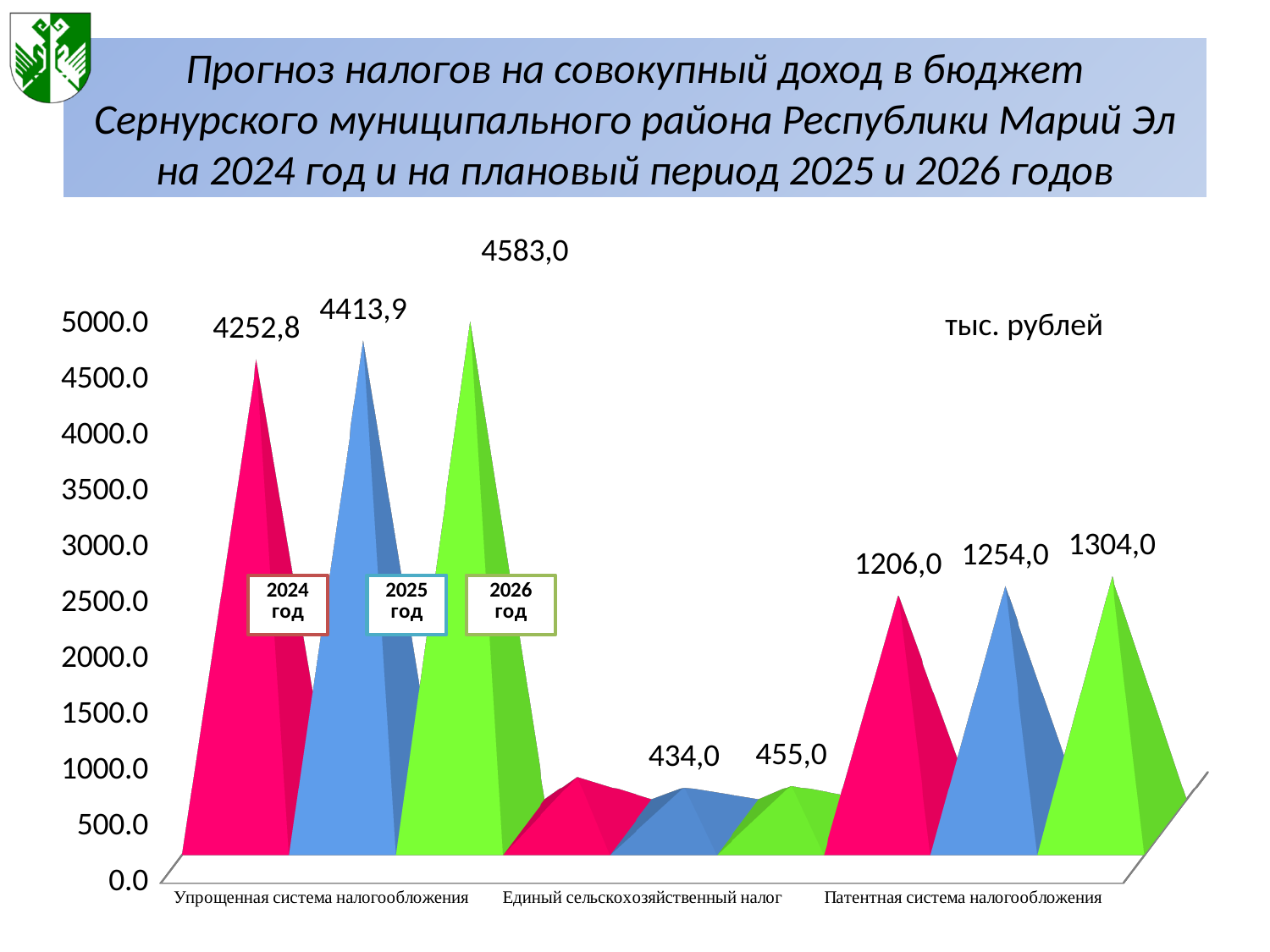
What is the forecast value for Патентная система налогообложения in 2024? 1206,0 How many years (series) does the chart show? 3 Which is larger: the 2025 value for Упрощенная система налогообложения or the 2026 value for Патентная система налогообложения? 2025 value for Упрощенная система налогообложения How many tax categories are shown on the x axis? 3 What is the difference between the 2026 and 2025 forecast values for Патентная система налогообложения? 50,0 Which tax category has the highest forecast values? Упрощенная система налогообложения What is the difference between the 2026 and 2024 forecast values for Упрощенная система налогообложения? 330,2 What is the forecast value for Патентная система налогообложения in 2025? 1254,0 Which tax category has the lowest forecast values? Единый сельскохозяйственный налог What is the forecast value for Упрощенная система налогообложения in 2024? 4252,8 What is the forecast value for Упрощенная система налогообложения in 2026? 4583,0 Are the values for Единый сельскохозяйственный налог greater or less than 1000.0? less